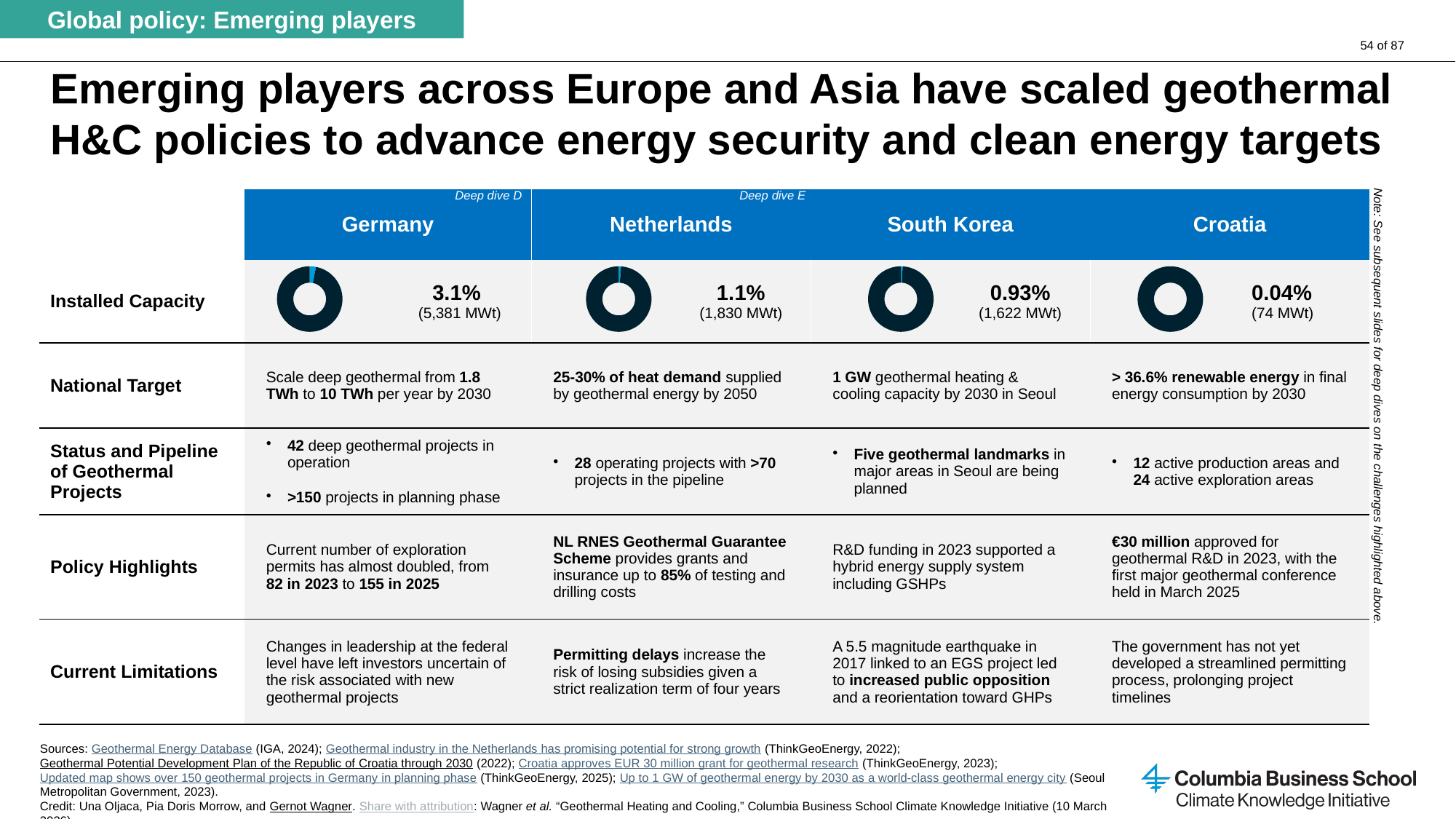
Which has a larger installed capacity, South Korea or Croatia? South Korea Which country's donut chart shows the lowest installed capacity percentage? Croatia What installed capacity percentage is shown in the donut chart for South Korea? 0.93% What share of the donut chart for the Netherlands is highlighted as installed capacity? 1.1% What kind of chart is used to show installed capacity for each country? Donut (pie) chart What installed capacity percentage is shown in the donut chart for Germany? 3.1% How many donut charts are shown in the Installed Capacity row? 4 What installed capacity in MWt is shown next to the Croatia donut chart? 74 MWt What installed capacity in MWt is shown next to the Netherlands donut chart? 1,830 MWt What is the difference in installed capacity (MWt) between Germany and the Netherlands? 3,551 MWt What is the difference in installed capacity (MWt) between the Netherlands and South Korea? 208 MWt Which country's donut chart shows the highest installed capacity percentage? Germany